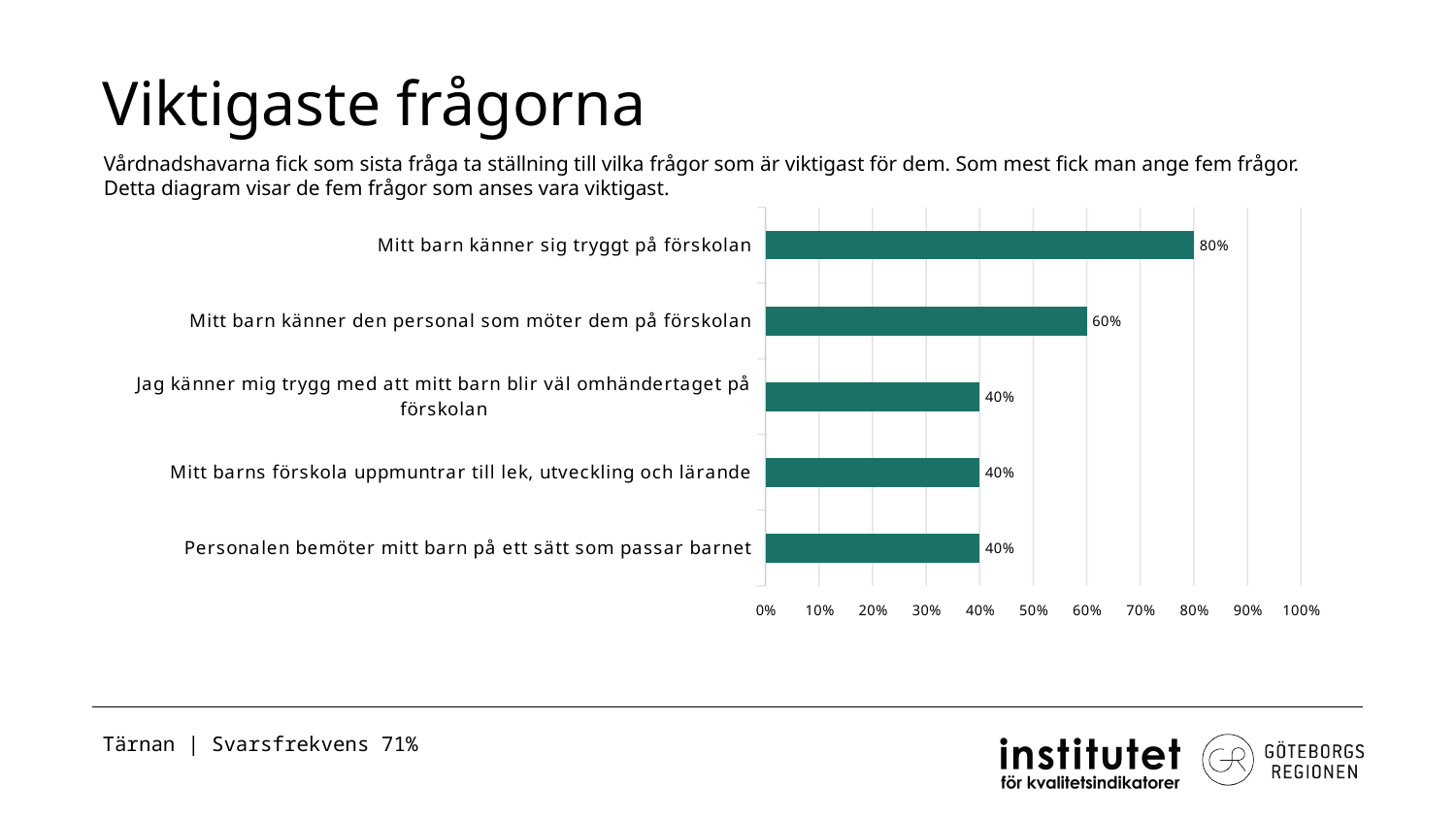
What is the value for "Mitt barn känner sig tryggt på förskolan"? 80% What is the difference between the values for "Mitt barn känner den personal som möter dem på förskolan" and "Mitt barns förskola uppmuntrar till lek, utveckling och lärande"? 20% What is the value for "Personalen bemöter mitt barn på ett sätt som passar barnet"? 40% What kind of chart is shown on the slide? bar chart Which is larger: the value for "Mitt barn känner den personal som möter dem på förskolan" or the value for "Jag känner mig trygg med att mitt barn blir väl omhändertaget på förskolan"? Mitt barn känner den personal som möter dem på förskolan What is the title of the slide? Viktigaste frågorna How many categories are shown in the chart? 5 Is the value for "Mitt barn känner sig tryggt på förskolan" greater or less than 50%? greater Which category has the highest value? Mitt barn känner sig tryggt på förskolan What is the difference between the values for "Mitt barn känner sig tryggt på förskolan" and "Mitt barn känner den personal som möter dem på förskolan"? 20% How many categories have a value of 40%? 3 What is the value for "Mitt barn känner den personal som möter dem på förskolan"? 60%